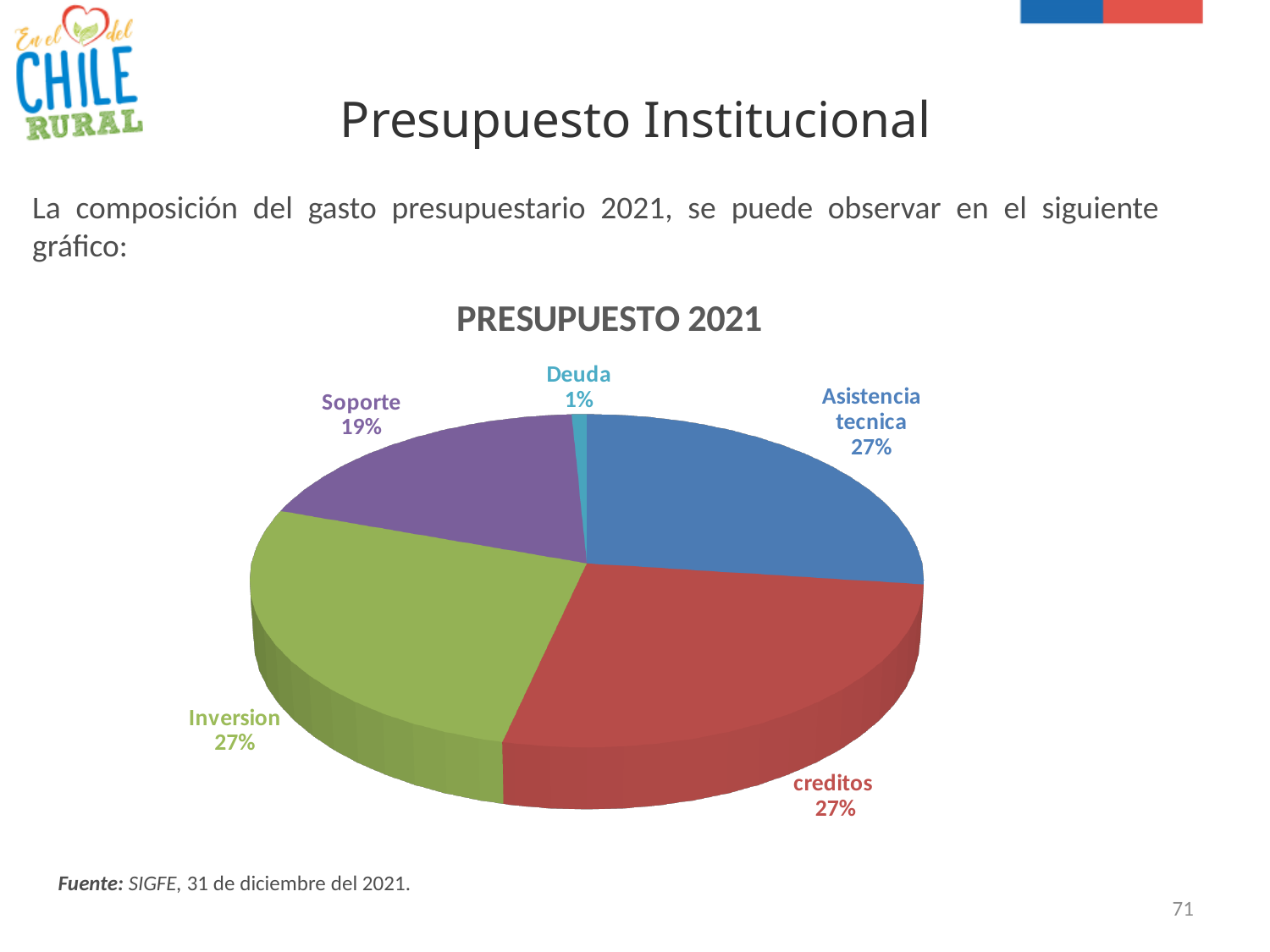
What share of the pie does Inversion represent? 27% What colour is the Inversion slice? green What kind of chart is shown on the slide? pie chart What is the difference in percentage points between Soporte and Deuda? 18 What share of the pie does Deuda represent? 1% What share of the pie does Asistencia tecnica represent? 27% How many categories are shown in the pie chart? 5 What is the title of the chart? PRESUPUESTO 2021 Which is larger, the share for Soporte or the share for creditos? creditos Which category has the smallest slice of the pie? Deuda What is the difference in percentage points between creditos and Soporte? 8